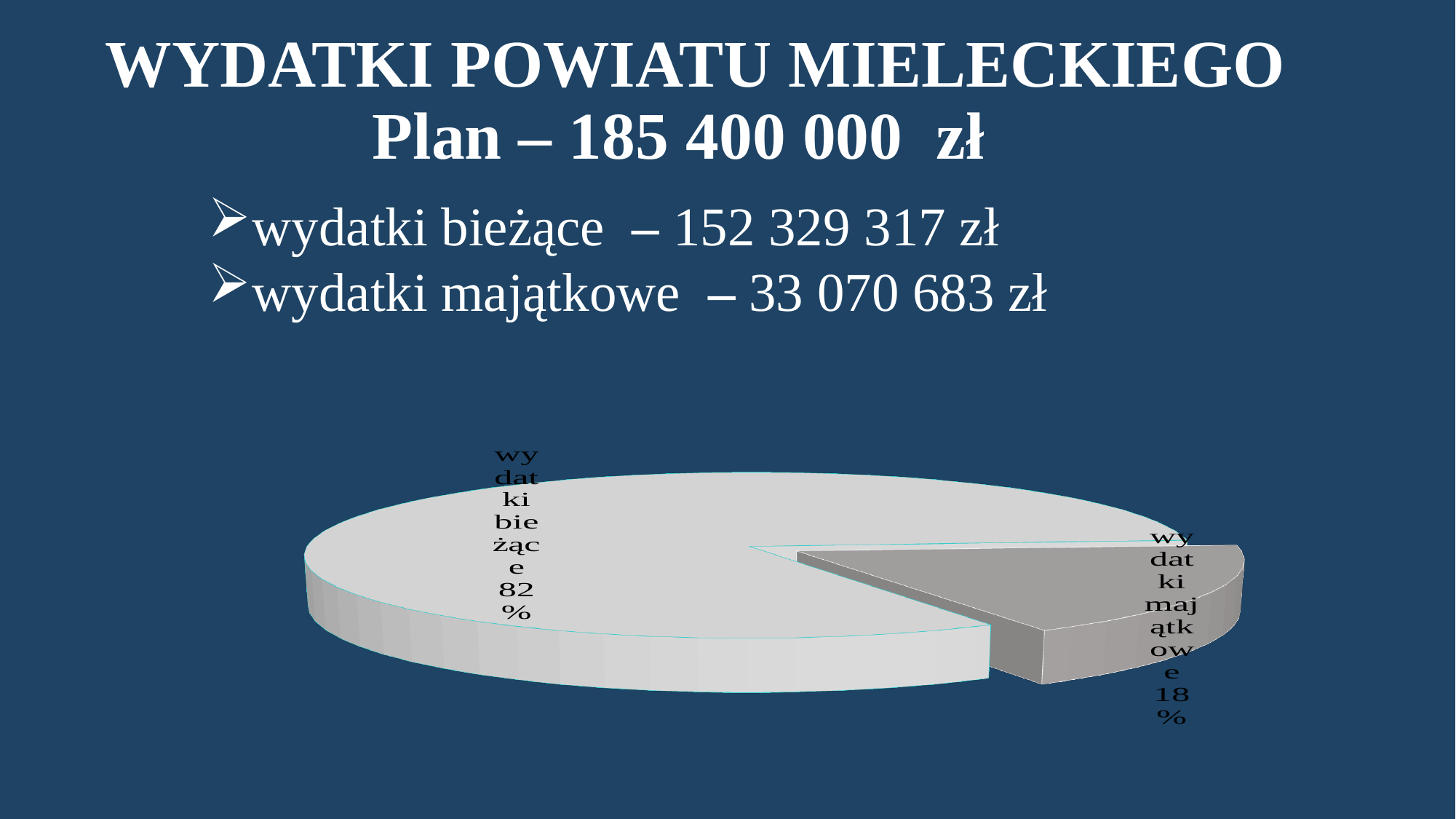
What kind of chart is shown on the slide? pie chart What share of the pie does the slice 'wydatki bieżące' represent? 82% Which slice of the pie chart is the largest? wydatki bieżące Which slice is larger, 'wydatki bieżące' or 'wydatki majątkowe'? wydatki bieżące By how many percentage points does the share of 'wydatki bieżące' exceed the share of 'wydatki majątkowe'? 64 percentage points Which slice is pulled out (exploded) from the pie chart? wydatki majątkowe What share of the pie does the slice 'wydatki majątkowe' represent? 18% Which slice of the pie chart is the smallest? wydatki majątkowe How many slices does the pie chart have? 2 Is the share of 'wydatki majątkowe' greater or less than 50%? less What is the total of the two slice percentages shown on the pie chart? 100%